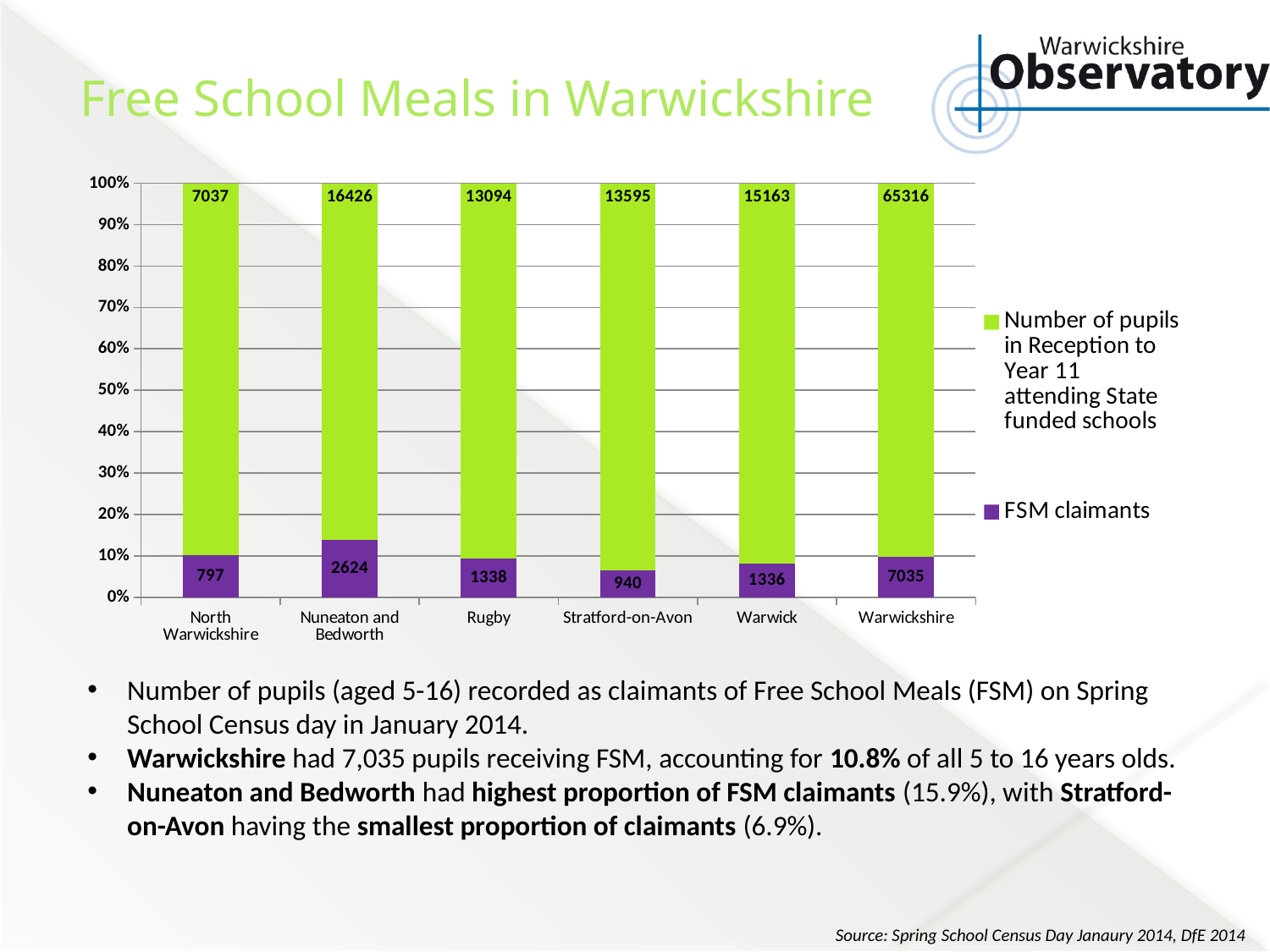
What is the difference between the number of FSM claimants in Nuneaton and Bedworth and in Stratford-on-Avon? 1684 What is the number of FSM claimants in Stratford-on-Avon? 940 What is the difference between the number of pupils attending State funded schools in Warwick and in Rugby? 2069 What is the number of pupils in Reception to Year 11 attending State funded schools in Rugby? 13094 What is the number of FSM claimants in Nuneaton and Bedworth? 2624 How many series does the legend list? 2 Which has more FSM claimants, Nuneaton and Bedworth or Rugby? Nuneaton and Bedworth Which category has the highest number of FSM claimants? Warwickshire Is the FSM claimants share of the bar for Nuneaton and Bedworth greater or less than 10%? greater What kind of chart is shown on the slide? Stacked bar chart Which category has the lowest number of pupils in Reception to Year 11 attending State funded schools? North Warwickshire How many categories are shown on the x axis? 6